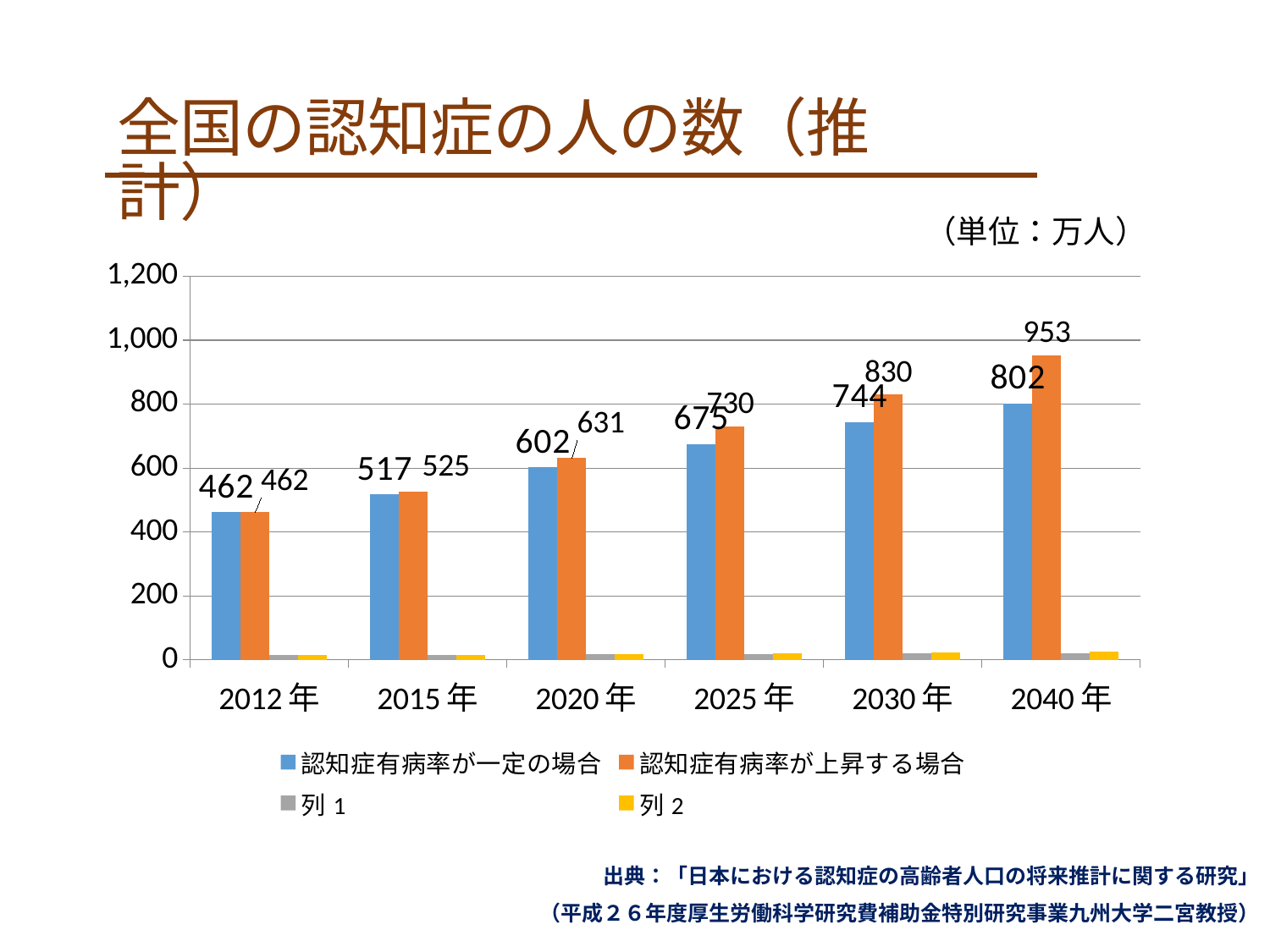
Which year has the highest value for 認知症有病率が上昇する場合? 2040年 How many series does the legend list? 4 What is the value for 認知症有病率が一定の場合 in 2040年? 802 What is the difference between 認知症有病率が上昇する場合 and 認知症有病率が一定の場合 in 2040年? 151 Which year has the lowest value for 認知症有病率が一定の場合? 2012年 What kind of chart is shown on the slide? Bar chart Do the values for 認知症有病率が上昇する場合 rise or fall from 2012年 to 2040年? Rise What is the value for 認知症有病率が上昇する場合 in 2030年? 830 In 2030年, which is larger: 認知症有病率が一定の場合 or 認知症有病率が上昇する場合? 認知症有病率が上昇する場合 What is the difference between the 2025年 and 2012年 values for 認知症有病率が一定の場合? 213 How many years are shown on the x axis? 6 What is the value for 認知症有病率が上昇する場合 in 2020年? 631